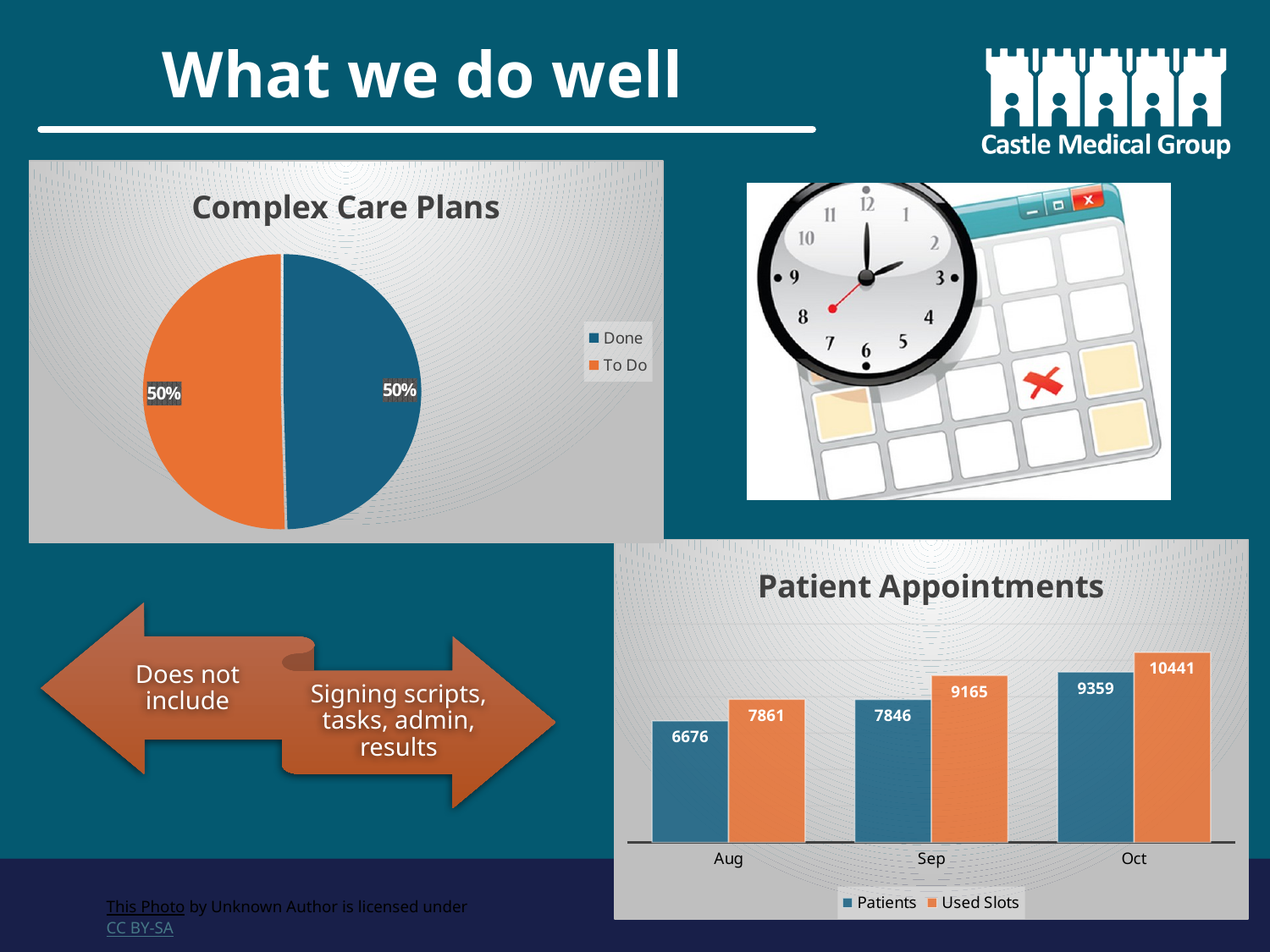
In the Patient Appointments chart, what is the difference between Used Slots and Patients in Sep? 1319 In the Patient Appointments chart, which is larger in Aug: Patients or Used Slots? Used Slots In the Patient Appointments chart, what is the value for Used Slots in Oct? 10441 How many entries does the legend of the Complex Care Plans chart list? 2 In the Patient Appointments chart, what is the value for Used Slots in Sep? 9165 In the Patient Appointments chart, what is the value for Patients in Aug? 6676 In the Patient Appointments chart, do the Patients values rise or fall from Aug to Oct? Rise What kind of chart is the Complex Care Plans chart? Pie chart In the Complex Care Plans chart, what share of the pie is labelled Done? 50% How many months are shown on the x axis of the Patient Appointments chart? 3 In the Complex Care Plans chart, what share of the pie is labelled To Do? 50% In the Patient Appointments chart, which month has the highest value for Patients? Oct